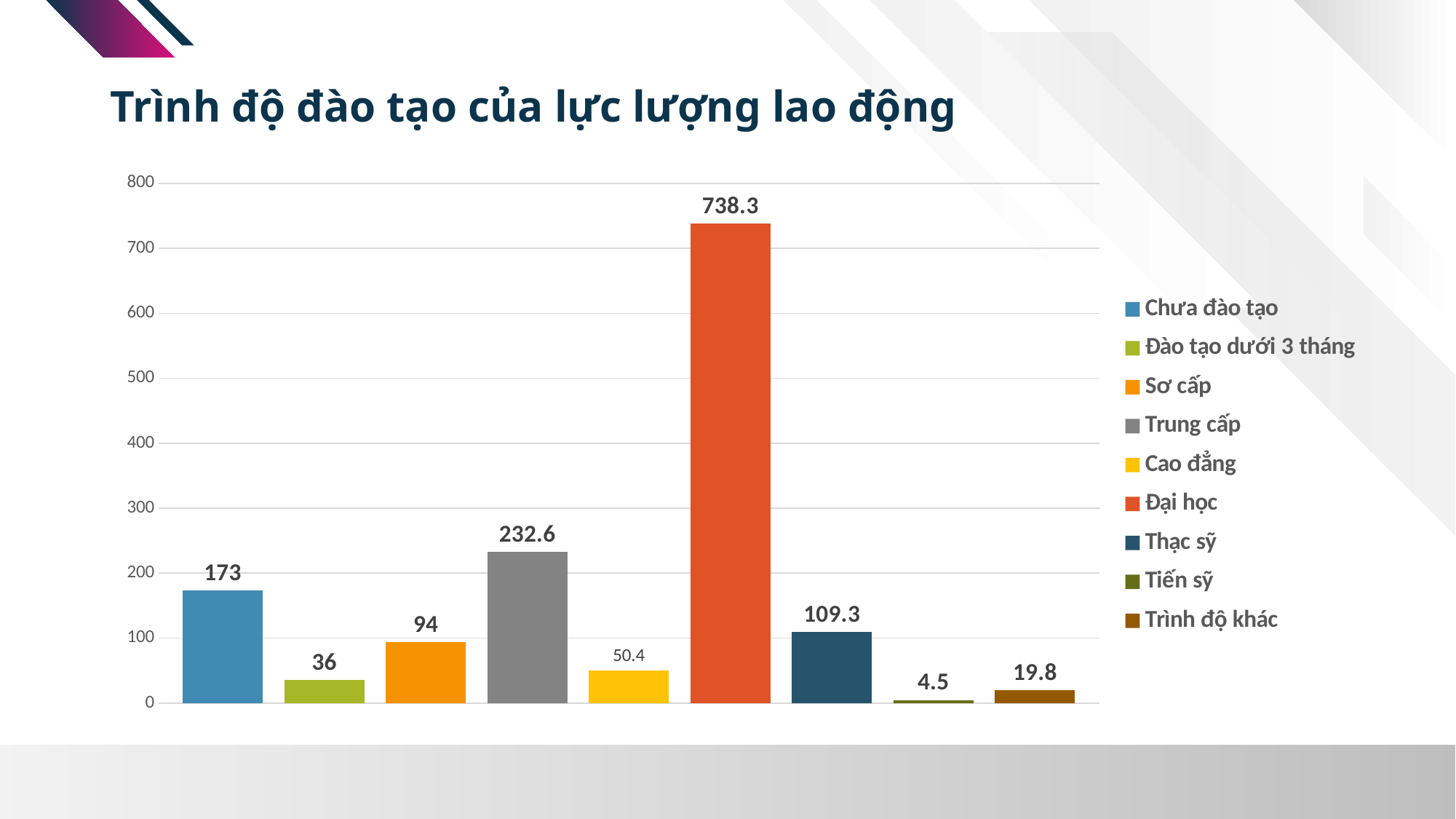
Which category has the highest value? Đại học What is the difference between the values for Trung cấp and Thạc sỹ? 123.3 What colour is the bar for Đại học? orange-red What is the value for Đại học? 738.3 What is the title of the chart? Trình độ đào tạo của lực lượng lao động What is the value for Cao đẳng? 50.4 Is the value for Trung cấp greater or less than 200? greater What is the value for Chưa đào tạo? 173 How many categories are shown in the chart? 9 Which category has the lowest value? Tiến sỹ What kind of chart is shown on the slide? bar chart Which is larger, the value for Sơ cấp or the value for Cao đẳng? Sơ cấp